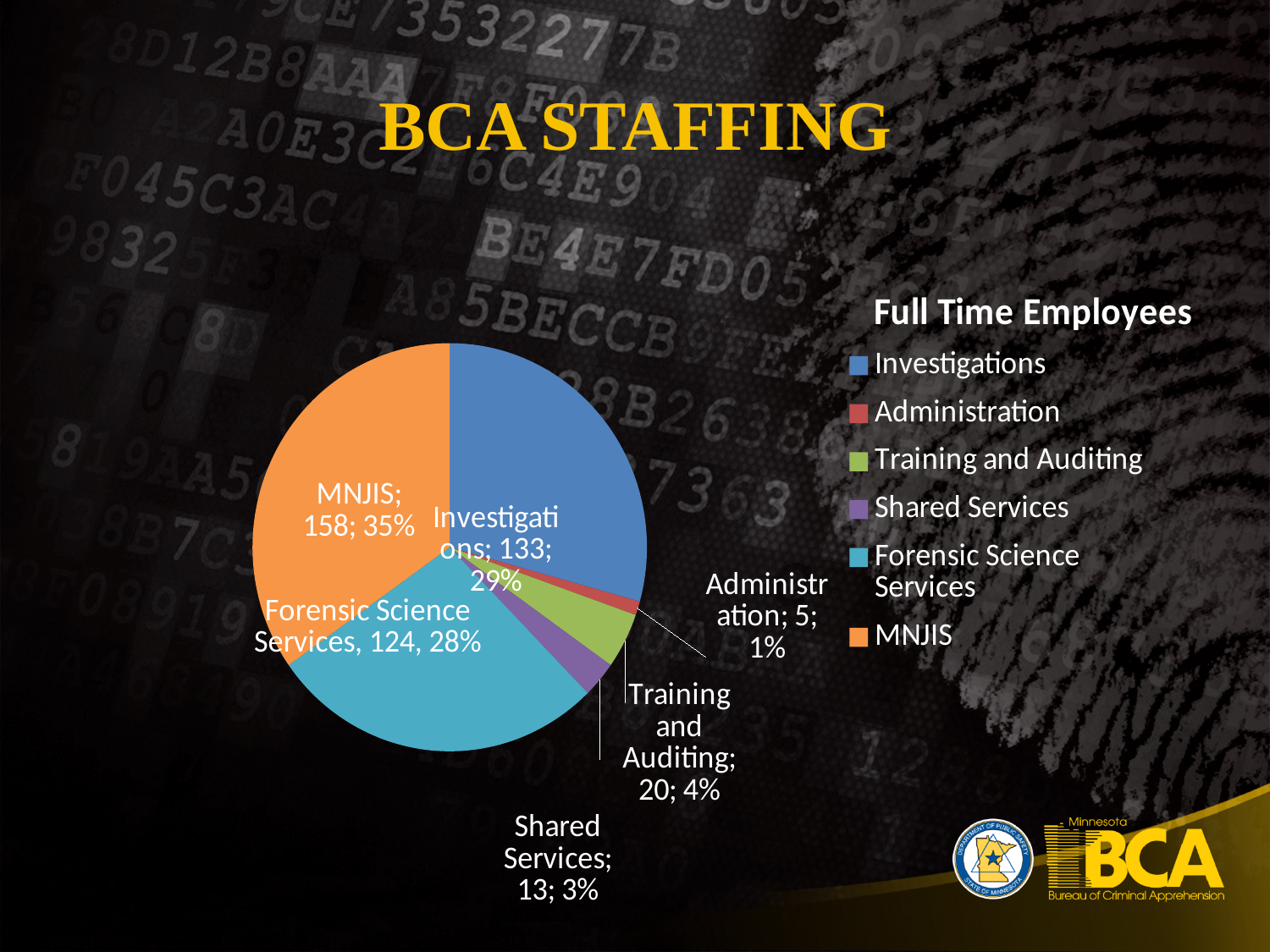
How many full time employees are in Investigations? 133 Which has more full time employees, Training and Auditing or Shared Services? Training and Auditing Which category has the fewest full time employees? Administration How many categories does the pie chart show? 6 How many full time employees are in Administration? 5 How many full time employees are in Forensic Science Services? 124 What share of full time employees does Training and Auditing account for? 4% What is the difference in full time employees between MNJIS and Investigations? 25 What kind of chart is shown on the slide? Pie chart What share of full time employees does MNJIS account for? 35% What is the title of the chart? Full Time Employees Which category has the most full time employees? MNJIS